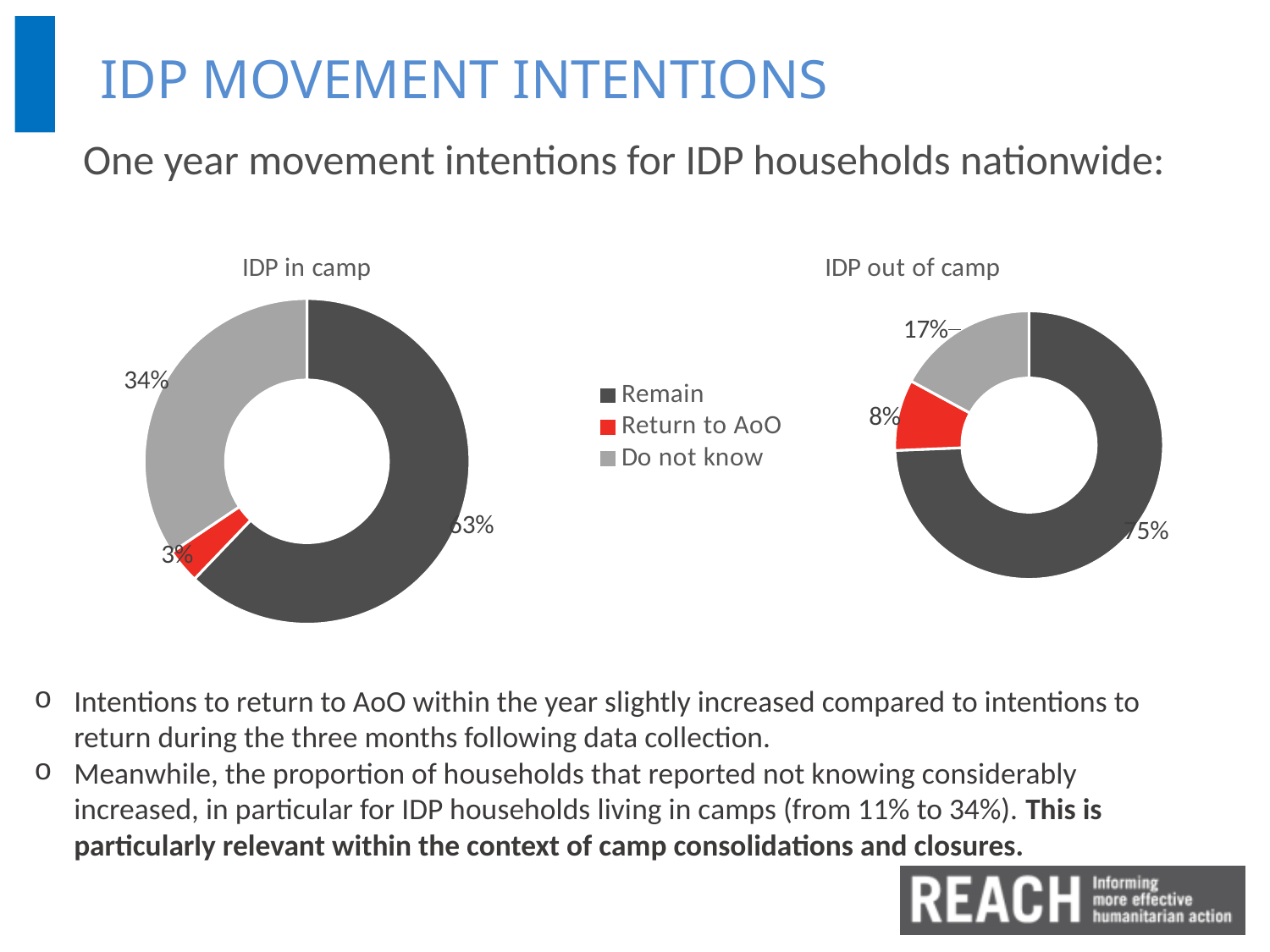
In the 'IDP in camp' chart, which category has the smallest share? Return to AoO Which chart shows a larger share for 'Do not know', 'IDP in camp' or 'IDP out of camp'? IDP in camp In the 'IDP out of camp' chart, which category has the largest share? Remain In the 'IDP out of camp' chart, what percentage of households reported 'Do not know'? 17% What colour represents 'Return to AoO' in the charts? Red In the 'IDP in camp' chart, which category has the largest share? Remain In the 'IDP out of camp' chart, what percentage of households intend to 'Return to AoO'? 8% What is the difference between the 'Do not know' share in the 'IDP in camp' chart and in the 'IDP out of camp' chart? 17 percentage points In the 'IDP out of camp' chart, what percentage of households intend to 'Remain'? 75% In the 'IDP in camp' chart, what percentage of households reported 'Do not know'? 34% How many categories does the shared legend list for the two charts? 3 In the 'IDP in camp' chart, what percentage of households intend to 'Return to AoO'? 3%